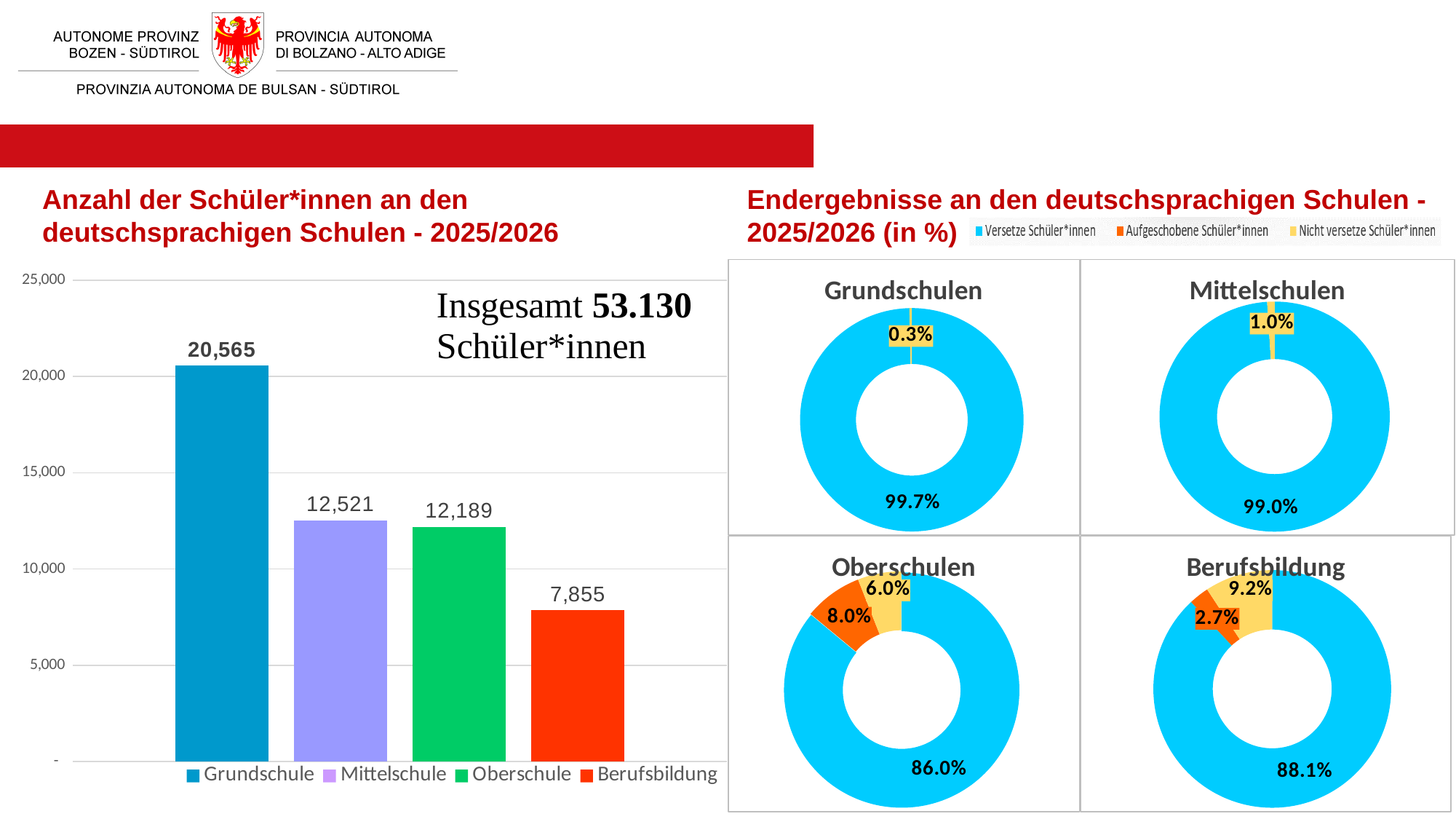
In the bar chart on the left, which category has the highest value? Grundschule In the bar chart on the left, which category has the lowest value? Berufsbildung In the bar chart on the left, how many categories are shown? 4 What kind of chart is the chart on the left of the slide? Bar chart In the 'Grundschulen' donut chart, what share is shown for Versetze Schüler*innen? 99.7% In the bar chart 'Anzahl der Schüler*innen an den deutschsprachigen Schulen - 2025/2026', what is the value for Grundschule? 20,565 Is the share of Versetze Schüler*innen larger in the 'Oberschulen' donut chart or in the 'Berufsbildung' donut chart? Berufsbildung In the bar chart on the left, what is the difference between the values for Mittelschule and Oberschule? 332 In the bar chart on the left, what is the value for Berufsbildung? 7,855 How many series does the legend of the 'Endergebnisse an den deutschsprachigen Schulen - 2025/2026 (in %)' charts list? 3 In the 'Oberschulen' donut chart, what share is shown for Aufgeschobene Schüler*innen? 8.0% In the 'Berufsbildung' donut chart, what share is shown for Nicht versetze Schüler*innen? 9.2%